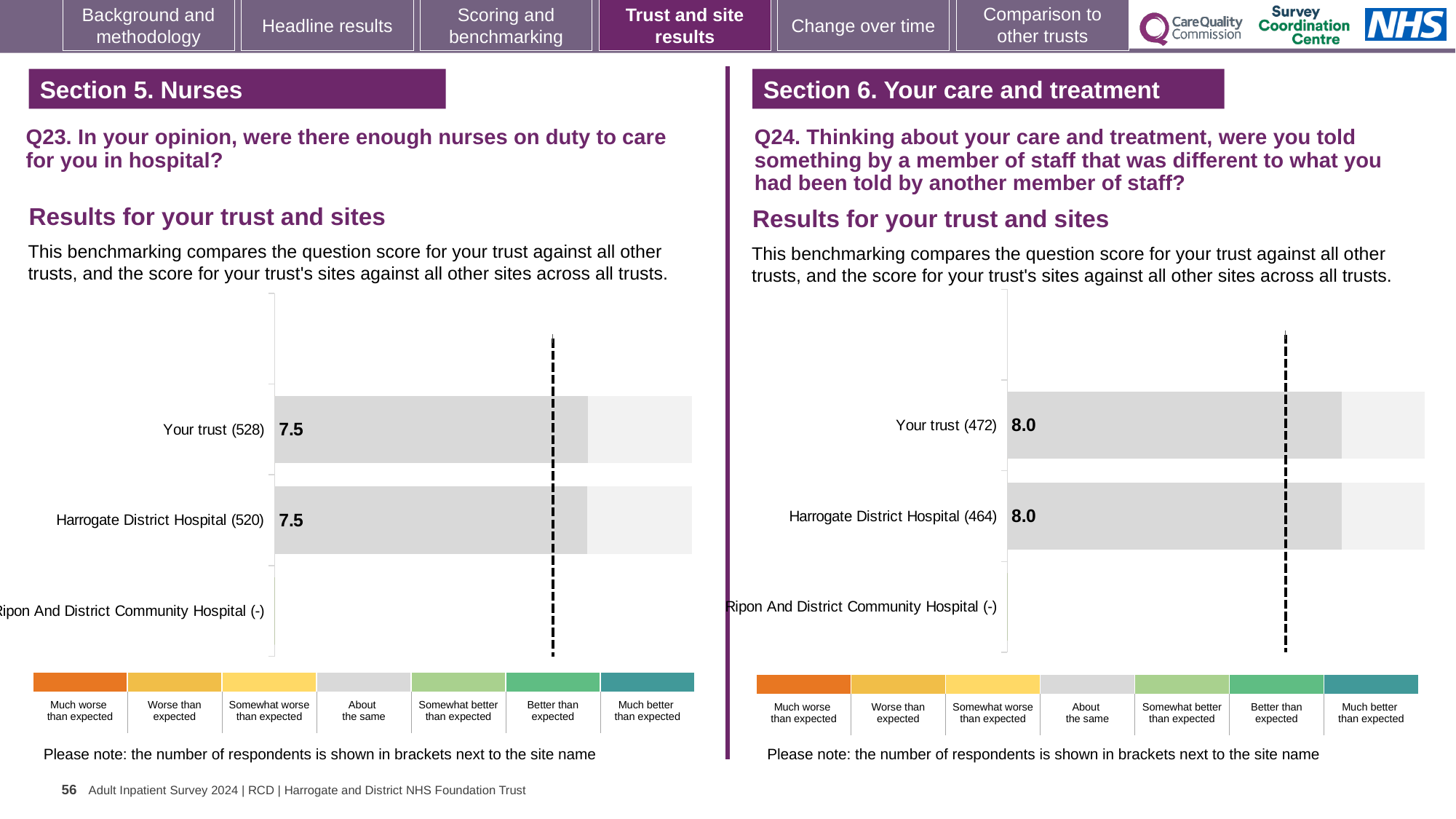
What kind of chart is used on the left (Q23) to show the results for your trust and sites? Bar chart On the left chart (Q23, enough nurses on duty), what is the score for Your trust? 7.5 On the left chart (Q23), what is the difference between the scores for Your trust and Harrogate District Hospital? 0.0 On the right chart (Q24), which category has no score shown (marked with a dash)? Ripon And District Community Hospital On the right chart (Q24, told something different by staff), what is the score for Harrogate District Hospital? 8.0 On the left chart (Q23, enough nurses on duty), what is the score for Harrogate District Hospital? 7.5 On the right chart (Q24), how many respondents are shown in brackets for Harrogate District Hospital? 464 On the right chart (Q24, told something different by staff), what is the score for Your trust? 8.0 How many site/trust categories are listed on the left chart (Q23)? 3 On the left chart (Q23), how many respondents are shown in brackets for Your trust? 528 On the right chart (Q24), what is the difference between the scores for Your trust and Harrogate District Hospital? 0.0 How many site/trust categories are listed on the right chart (Q24)? 3